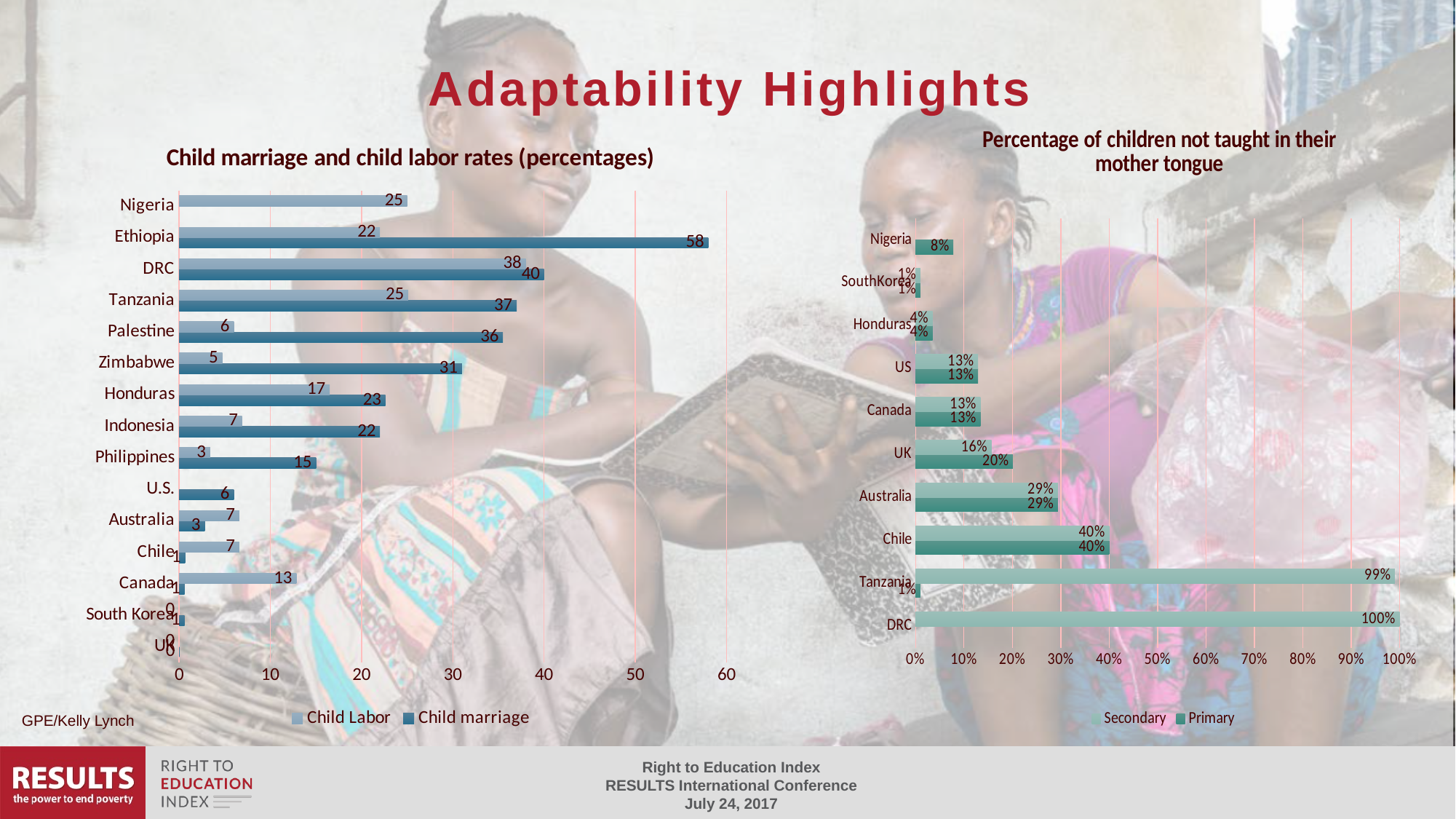
In the 'Child marriage and child labor rates' chart, what is the child labor rate for DRC? 38 In the 'Child marriage and child labor rates' chart, what is the child marriage rate for Ethiopia? 58 In the 'Percentage of children not taught in their mother tongue' chart, what is the Secondary value for Tanzania? 99% In the 'Child marriage and child labor rates' chart, which is larger for Australia: child labor or child marriage? Child Labor In the 'Child marriage and child labor rates' chart, which country has the highest child marriage rate? Ethiopia In the 'Percentage of children not taught in their mother tongue' chart, what is the difference between the Secondary and Primary values for Tanzania? 98% How many countries are listed in the 'Child marriage and child labor rates' chart? 15 What type of chart is the 'Percentage of children not taught in their mother tongue' chart? Bar chart In the 'Child marriage and child labor rates' chart, what is the difference between Tanzania's child marriage rate and its child labor rate? 12 How many series does the legend of the 'Child marriage and child labor rates' chart list? 2 In the 'Percentage of children not taught in their mother tongue' chart, which country has the highest Secondary value? DRC In the 'Percentage of children not taught in their mother tongue' chart, what is the Primary value for the UK? 20%